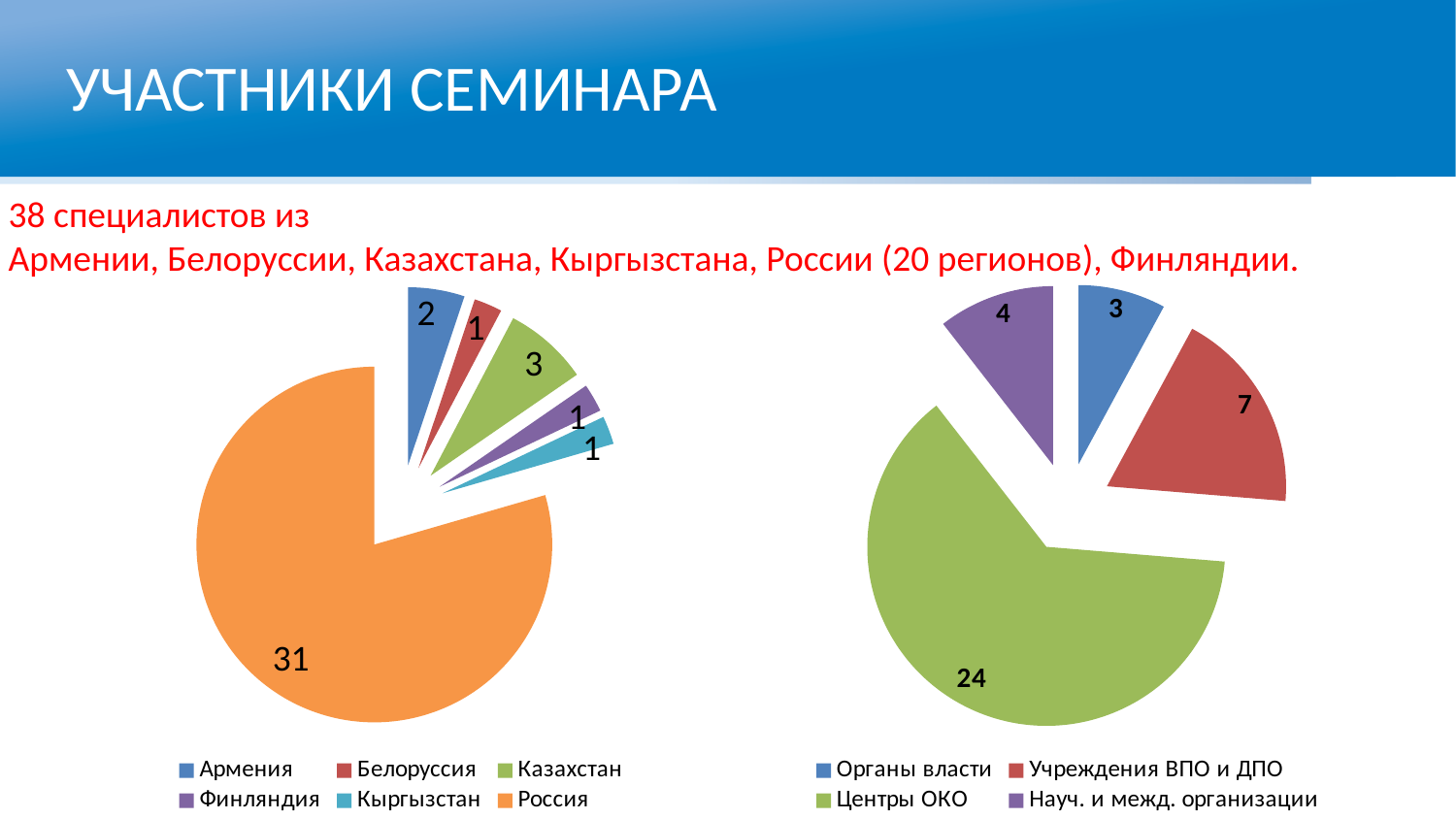
In the left pie chart, which country has the largest slice? Россия In the right pie chart, what is the value for Центры ОКО? 24 In the right pie chart, which is larger: Науч. и межд. организации or Учреждения ВПО и ДПО? Учреждения ВПО и ДПО In the left pie chart, what is the difference between the values for Россия and Казахстан? 28 In the right pie chart, which category has the smallest slice? Органы власти In the right pie chart, what is the value for Учреждения ВПО и ДПО? 7 In the left pie chart, how many participants are from Армения? 2 In the right pie chart, what is the total of all four slices? 38 In the left pie chart, how many participants are from Россия? 31 What type of chart is shown on the right side of the slide? Pie chart In the left pie chart, how many categories does the legend list? 6 In the left pie chart, how many participants are from Казахстан? 3